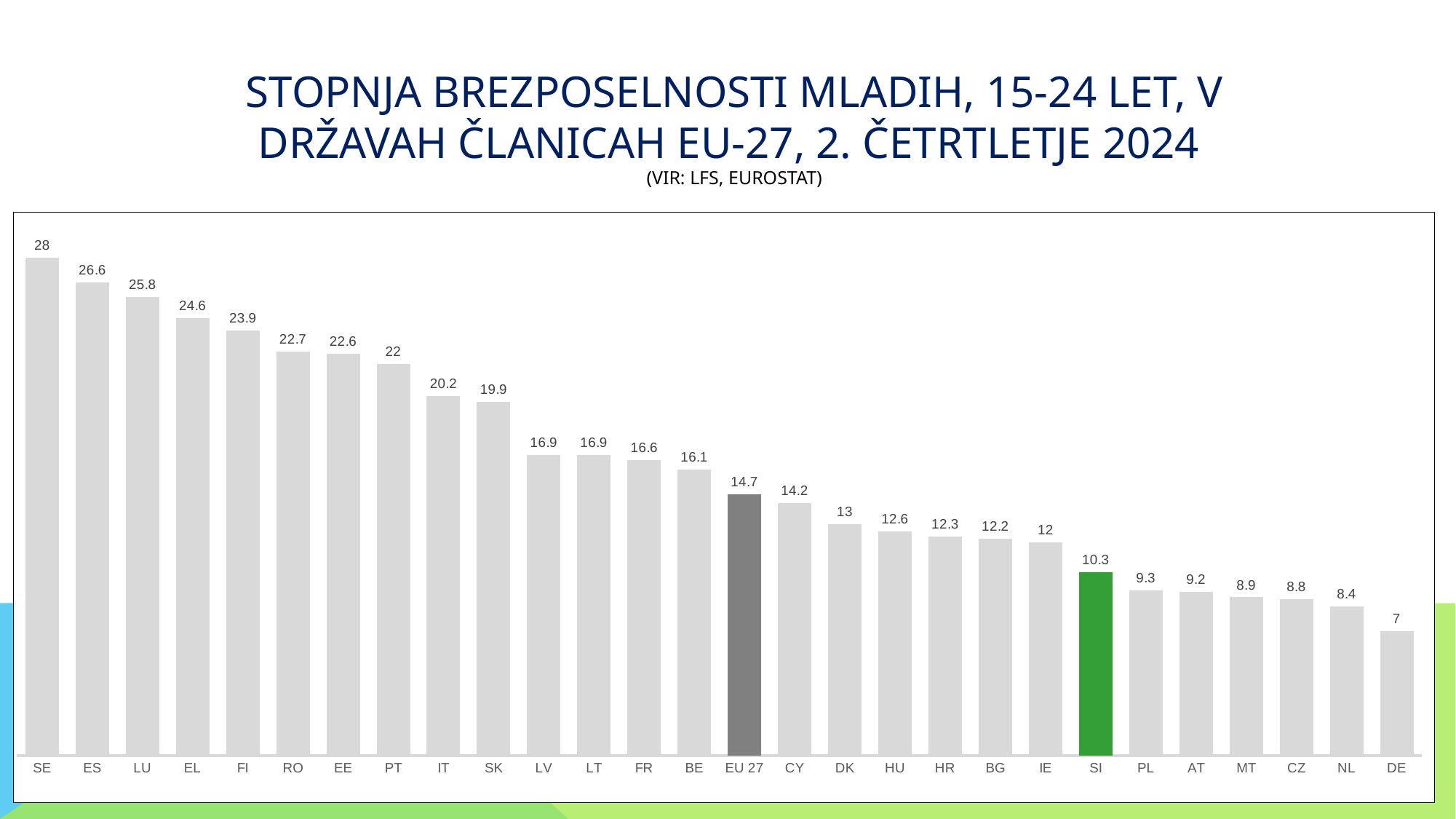
What type of chart is shown on the slide? Bar chart Do the values rise or fall from left to right along the x axis? Fall What is the difference between the values for SE and DE? 21 Which has a higher value, ES or LU? ES What is the difference between the EU 27 value and the SI value? 4.4 Which country has the highest youth unemployment rate on the chart? SE Which country has the lowest youth unemployment rate on the chart? DE What is the value shown for PT? 22 How many bars are shown on the chart? 28 What is the youth unemployment rate shown for SI? 10.3 What value is shown for EU 27? 14.7 Which bar is coloured green? SI